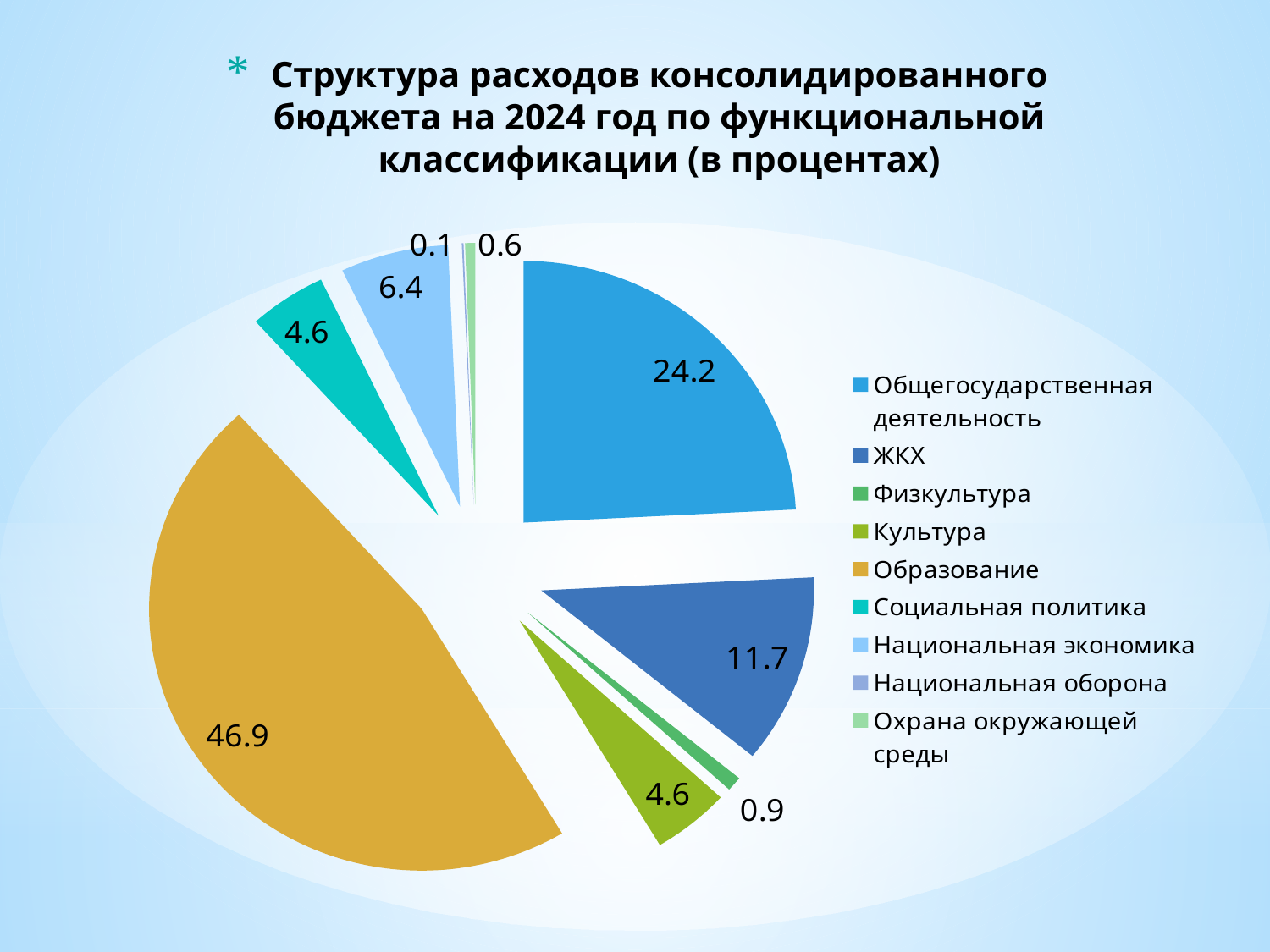
Which category has the smallest share of the pie? Национальная оборона What is the value for Общегосударственная деятельность? 24.2 What is the value for ЖКХ? 11.7 What is the value for Физкультура? 0.9 How many categories does the pie chart have? 9 What is the value for Образование? 46.9 What is the value for Национальная экономика? 6.4 What is the difference between the values for Образование and Общегосударственная деятельность? 22.7 What colour is the slice for Образование? Gold (yellow-orange) What type of chart is shown on the slide? Pie chart Which category has the largest share of the pie? Образование Which is larger, the value for ЖКХ or the value for Национальная экономика? ЖКХ